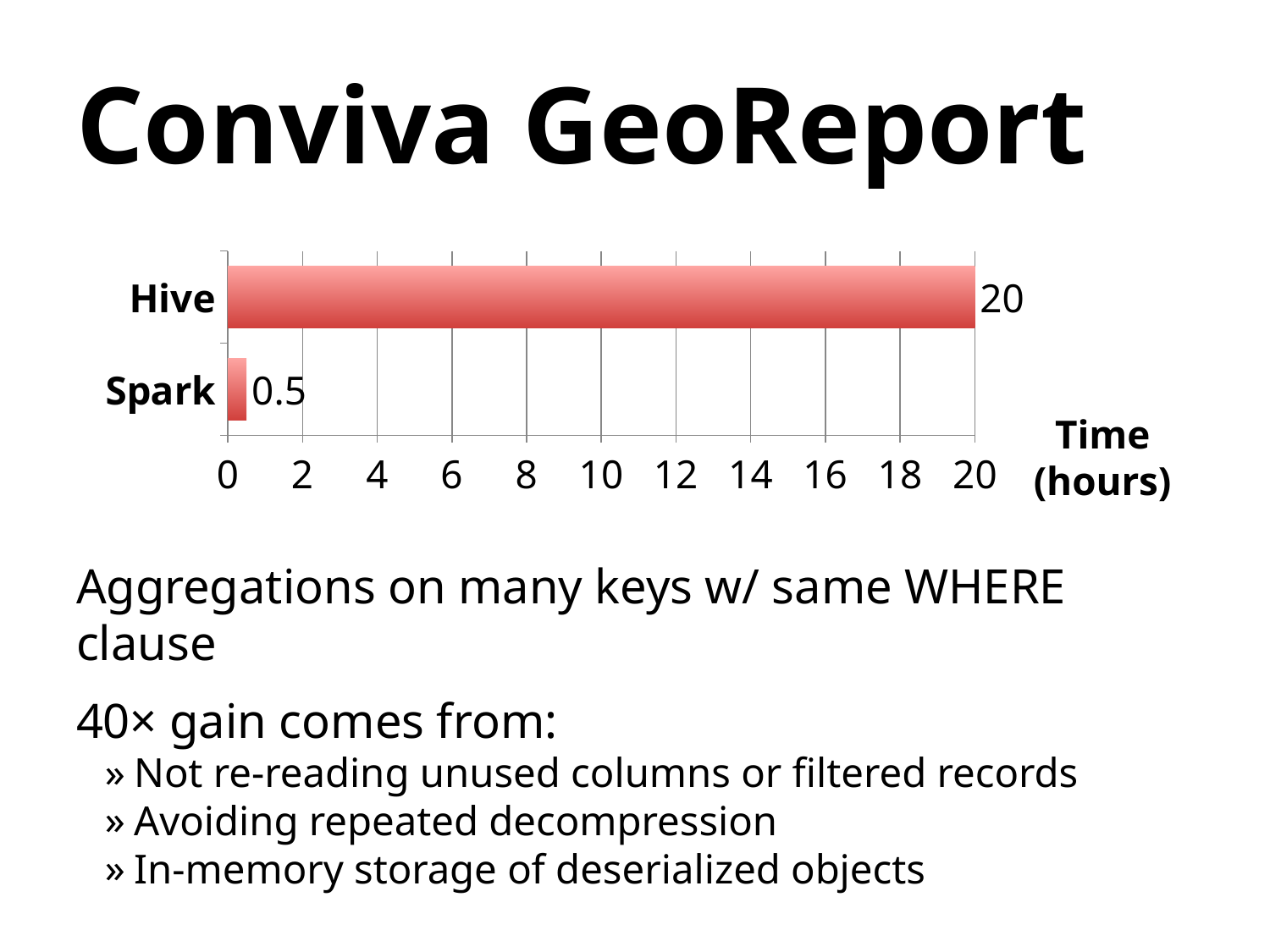
Is the value for Spark greater or less than 2? less Which is larger, the value for Hive or the value for Spark? Hive Which category has the highest value? Hive What is the value for Spark? 0.5 What is the label of the horizontal axis? Time (hours) What is the difference between the Hive and Spark values? 19.5 Is the value for Hive greater or less than 10? greater What is the maximum value shown on the horizontal axis? 20 Which category has the lowest value? Spark How many categories are shown in the chart? 2 What kind of chart is shown on the slide? bar chart What is the value for Hive? 20